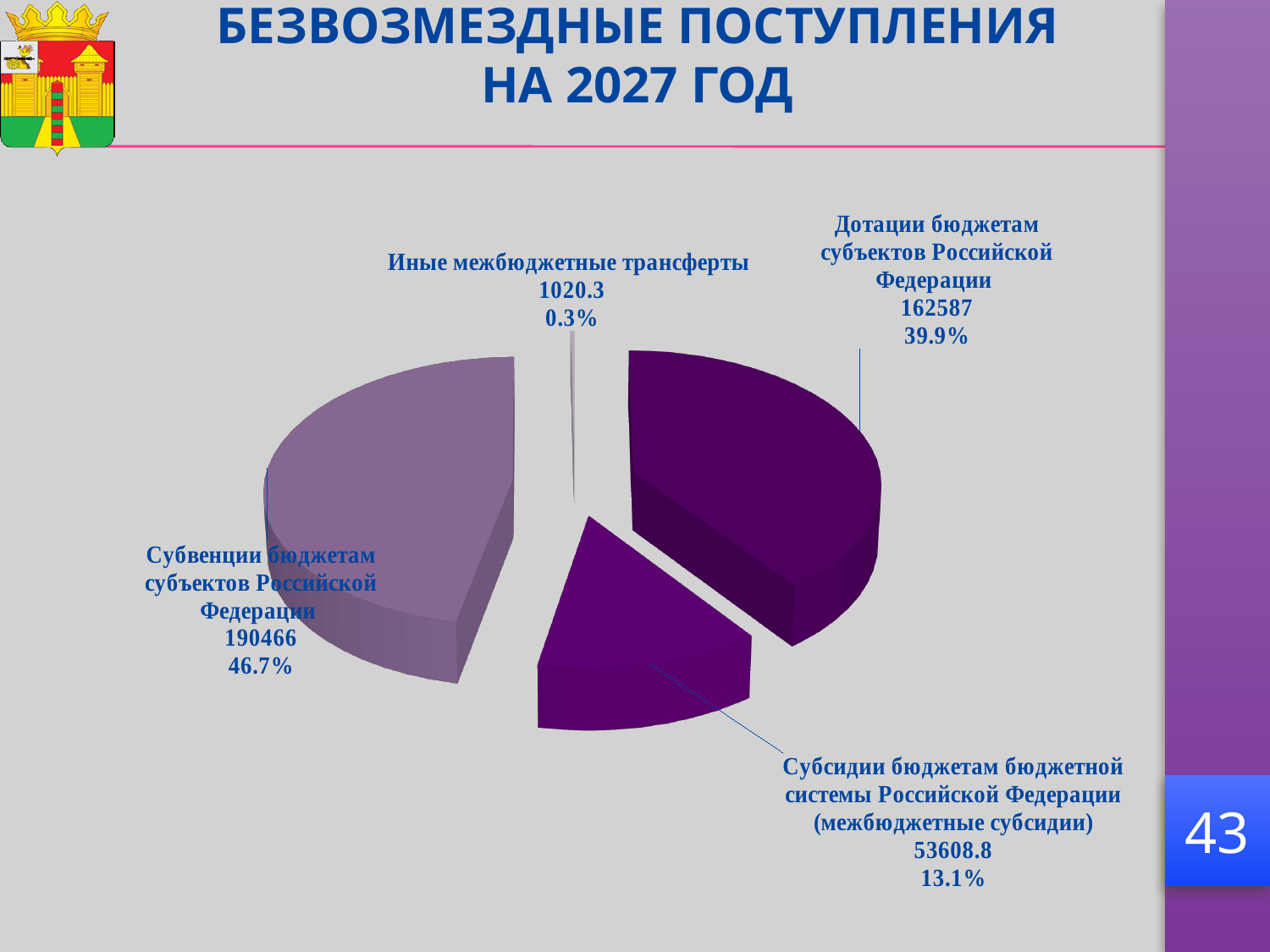
What share of the pie does Дотации бюджетам субъектов Российской Федерации represent? 39.9% How many slices does the pie chart have? 4 What kind of chart is shown on the slide? pie chart What is the value for Субсидии бюджетам бюджетной системы Российской Федерации (межбюджетные субсидии)? 53608.8 Which is larger: the value for Дотации бюджетам субъектов Российской Федерации or the value for Субсидии бюджетам бюджетной системы Российской Федерации (межбюджетные субсидии)? Дотации бюджетам субъектов Российской Федерации What share of the pie does Иные межбюджетные трансферты represent? 0.3% Which category has the largest slice of the pie? Субвенции бюджетам субъектов Российской Федерации What is the value for Иные межбюджетные трансферты? 1020.3 What is the value for Субвенции бюджетам субъектов Российской Федерации? 190466 What is the title of the slide containing the pie chart? БЕЗВОЗМЕЗДНЫЕ ПОСТУПЛЕНИЯ НА 2027 ГОД Which category has the smallest slice of the pie? Иные межбюджетные трансферты What is the value for Дотации бюджетам субъектов Российской Федерации? 162587